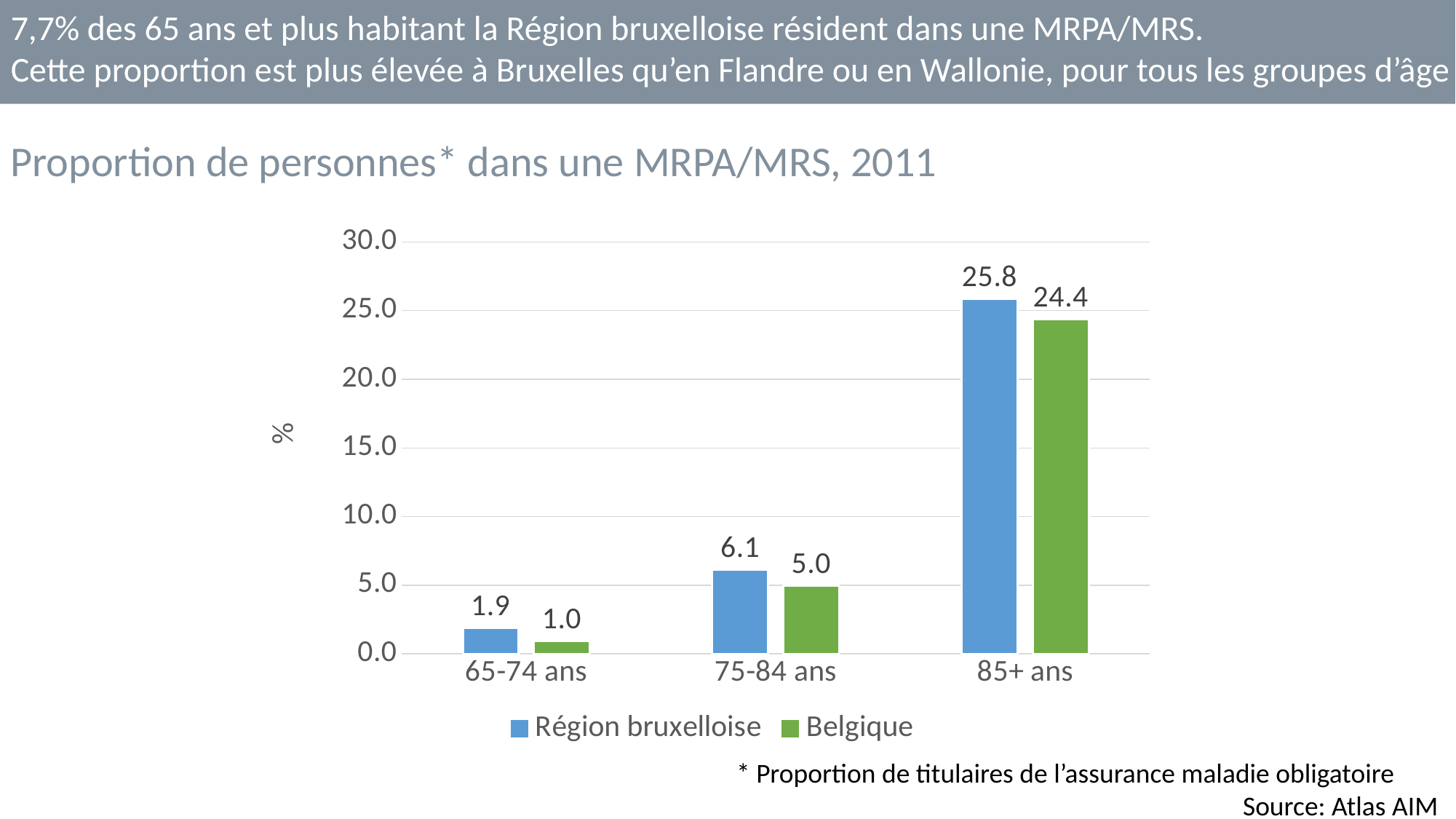
What is the value for Belgique in the 65-74 ans age group? 1.0 Is the value for Belgique in the 85+ ans age group greater or less than 20.0? greater What is the difference between Région bruxelloise and Belgique in the 75-84 ans age group? 1.1 What is the value for Région bruxelloise in the 85+ ans age group? 25.8 Which age group has the lowest value for Belgique? 65-74 ans Which age group has the highest value for Région bruxelloise? 85+ ans What is the value for Belgique in the 75-84 ans age group? 5.0 What is the difference between Région bruxelloise and Belgique in the 85+ ans age group? 1.4 What kind of chart is shown on the slide? Bar chart How many age groups are shown on the x axis? 3 Which is larger in the 65-74 ans age group: Région bruxelloise or Belgique? Région bruxelloise How many series does the legend list? 2